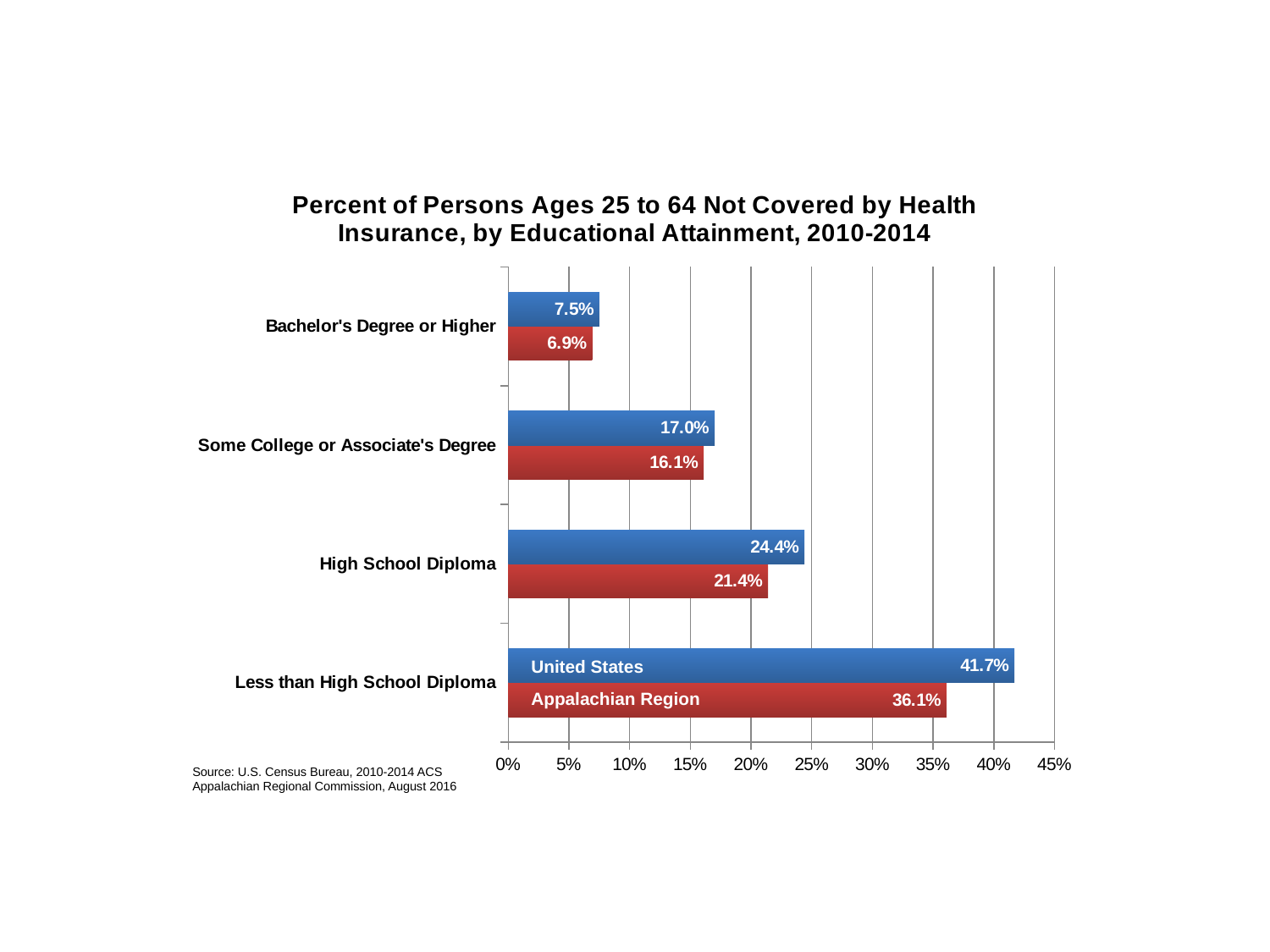
What is the difference between the United States and Appalachian Region values for Less than High School Diploma? 5.6% What is the United States value for Less than High School Diploma? 41.7% Which educational attainment category has the highest United States value? Less than High School Diploma What is the Appalachian Region value for Bachelor's Degree or Higher? 6.9% What is the Appalachian Region value for High School Diploma? 21.4% How many series does the chart show? 2 What kind of chart is shown on the slide? Bar chart How many educational attainment categories are shown in the chart? 4 What is the United States value for Some College or Associate's Degree? 17.0% Which educational attainment category has the lowest Appalachian Region value? Bachelor's Degree or Higher For Some College or Associate's Degree, which is larger: the United States value or the Appalachian Region value? United States What is the difference between the United States and Appalachian Region values for High School Diploma? 3.0%